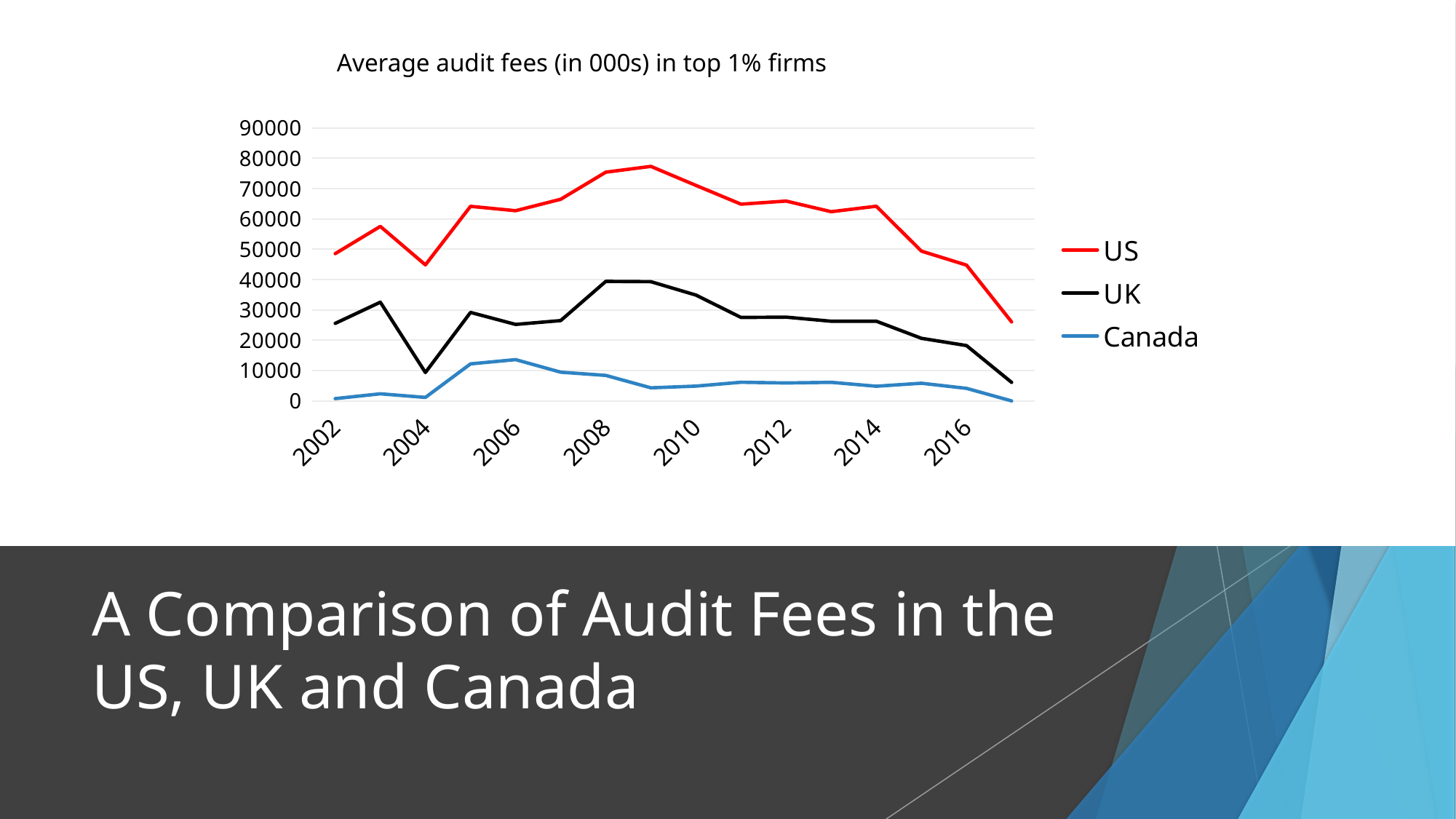
What kind of chart is shown on the slide? line chart Is the value for Canada in 2006 greater or less than 10000? greater Is the value for the US in 2004 greater or less than 50000? less In 2010, which series has the larger value, US or UK? US Which series has the highest value in 2012? US What is the title of the chart? Average audit fees (in 000s) in top 1% firms Does the US line rise or fall from 2014 to the end of the series? fall Which series has the lowest value in 2016? Canada Is the value for the US in 2008 greater or less than 70000? greater What colour is the line for the US series? red How many series does the legend list? 3